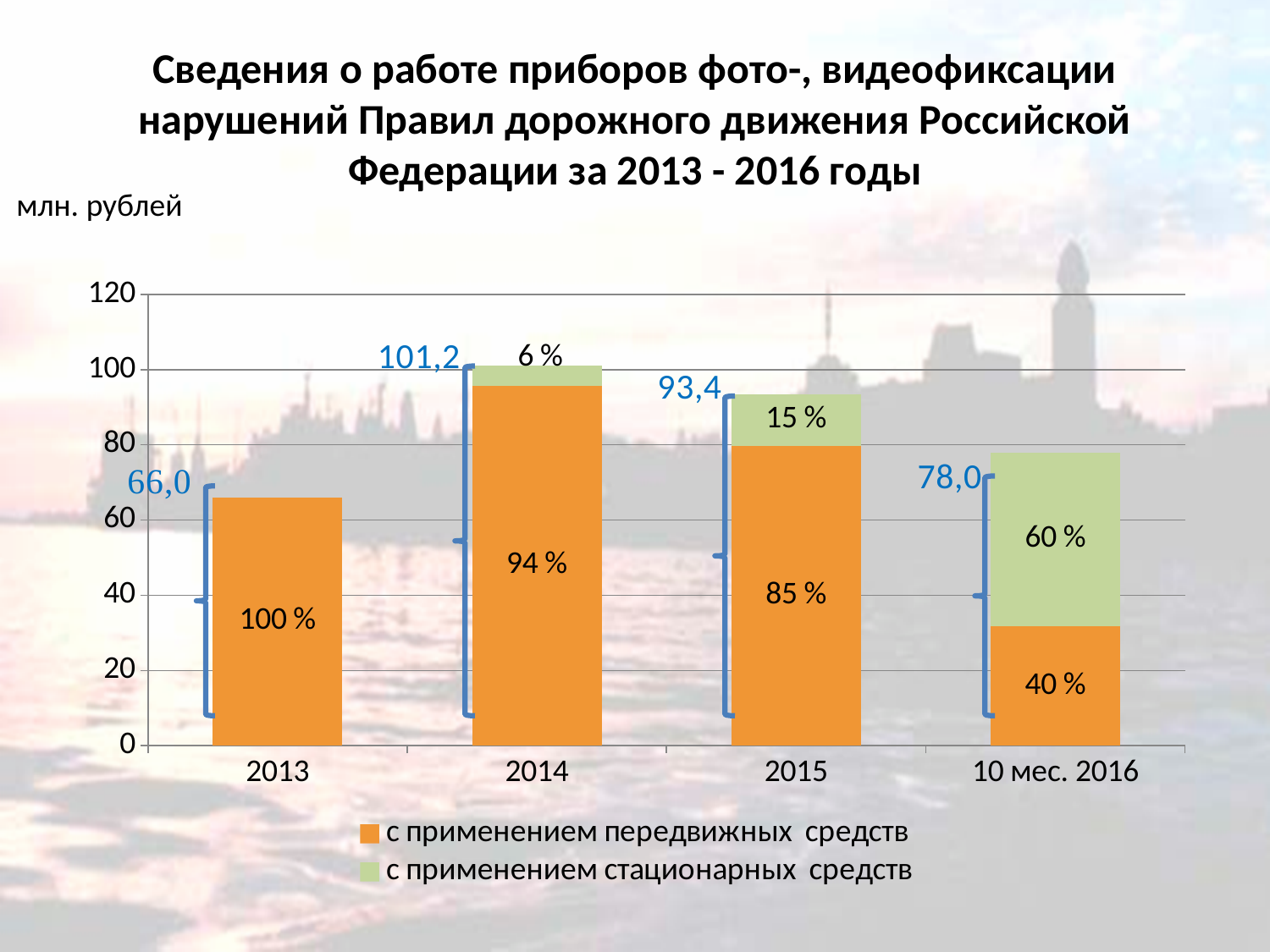
What is the total value shown for 10 мес. 2016? 78,0 What is the total value shown for 2014? 101,2 What kind of chart is shown on the slide? stacked bar chart What is the difference between the total values for 2014 and 2015? 7,8 How many periods are shown on the x axis? 4 Which period has the highest total value? 2014 What percentage share is labelled for the stationary devices (с применением стационарных средств) segment in 2015? 15 % What percentage share is labelled for the mobile devices (с применением передвижных средств) segment in 10 мес. 2016? 40 % Which total is larger, 2015 or 10 мес. 2016? 2015 How many series does the legend list? 2 Which period has the lowest total value? 2013 Is the total value for 2013 greater or less than 60? greater